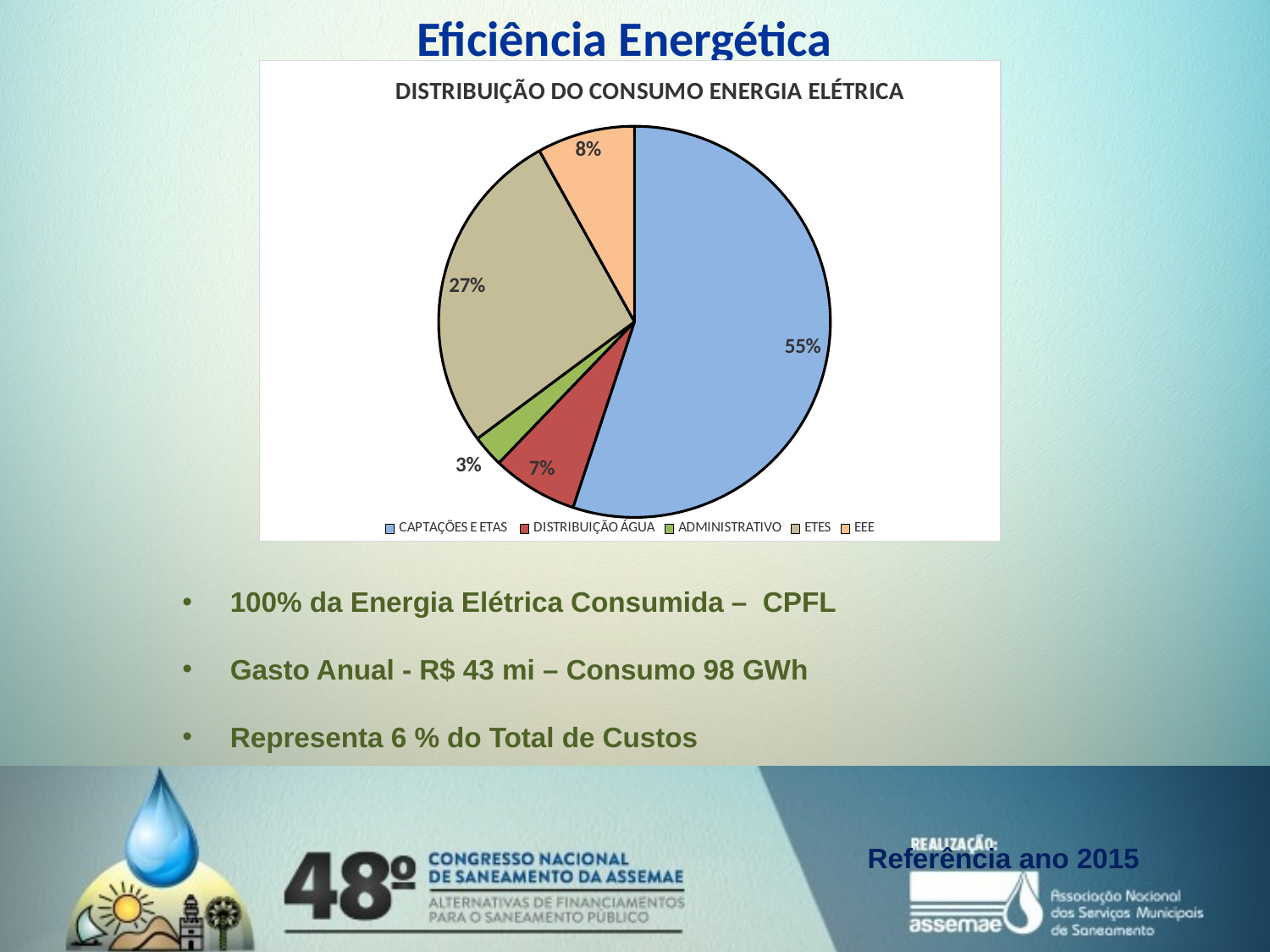
What is the difference in percentage points between CAPTAÇÕES E ETAS and ETES? 28 Which is larger, the share for EEE or the share for DISTRIBUIÇÃO ÁGUA? EEE What share of the pie does CAPTAÇÕES E ETAS represent? 55% What share of the pie does ETES represent? 27% What is the title of the chart? DISTRIBUIÇÃO DO CONSUMO ENERGIA ELÉTRICA What kind of chart is shown on the slide? Pie chart What share of the pie does DISTRIBUIÇÃO ÁGUA represent? 7% Which category has the smallest share of the pie? ADMINISTRATIVO Which category has the largest share of the pie? CAPTAÇÕES E ETAS How many slices does the pie chart have? 5